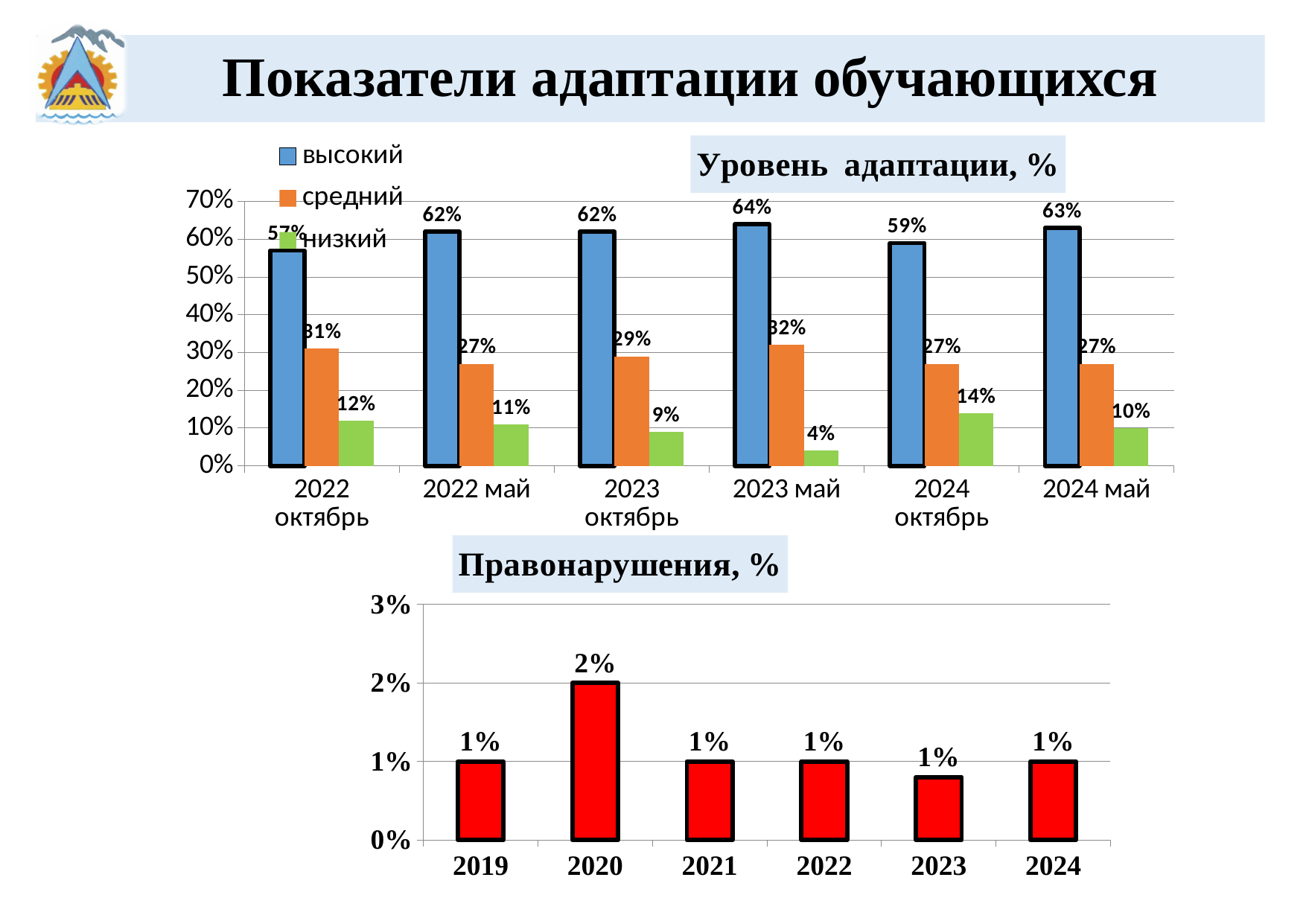
In the chart titled "Уровень адаптации, %", what is the value of the "высокий" series for "2023 май"? 64% What kind of chart is the chart titled "Правонарушения, %"? Bar chart In the chart titled "Уровень адаптации, %", how many series does the legend list? 3 In the chart titled "Уровень адаптации, %", what is the difference between the "высокий" values for "2023 май" and "2022 октябрь"? 7% In the chart titled "Уровень адаптации, %", which is larger: the "низкий" value for "2022 октябрь" or for "2023 май"? 2022 октябрь In the chart titled "Уровень адаптации, %", what is the value of the "низкий" series for "2024 октябрь"? 14% In the chart titled "Правонарушения, %", what is the value for 2020? 2% In the chart titled "Уровень адаптации, %", what is the value of the "средний" series for "2022 октябрь"? 31% In the chart titled "Уровень адаптации, %", which category has the highest value for the "высокий" series? 2023 май In the chart titled "Уровень адаптации, %", how many categories are shown on the x axis? 6 In the chart titled "Уровень адаптации, %", which category has the lowest value for the "низкий" series? 2023 май In the chart titled "Правонарушения, %", which year has the highest value? 2020